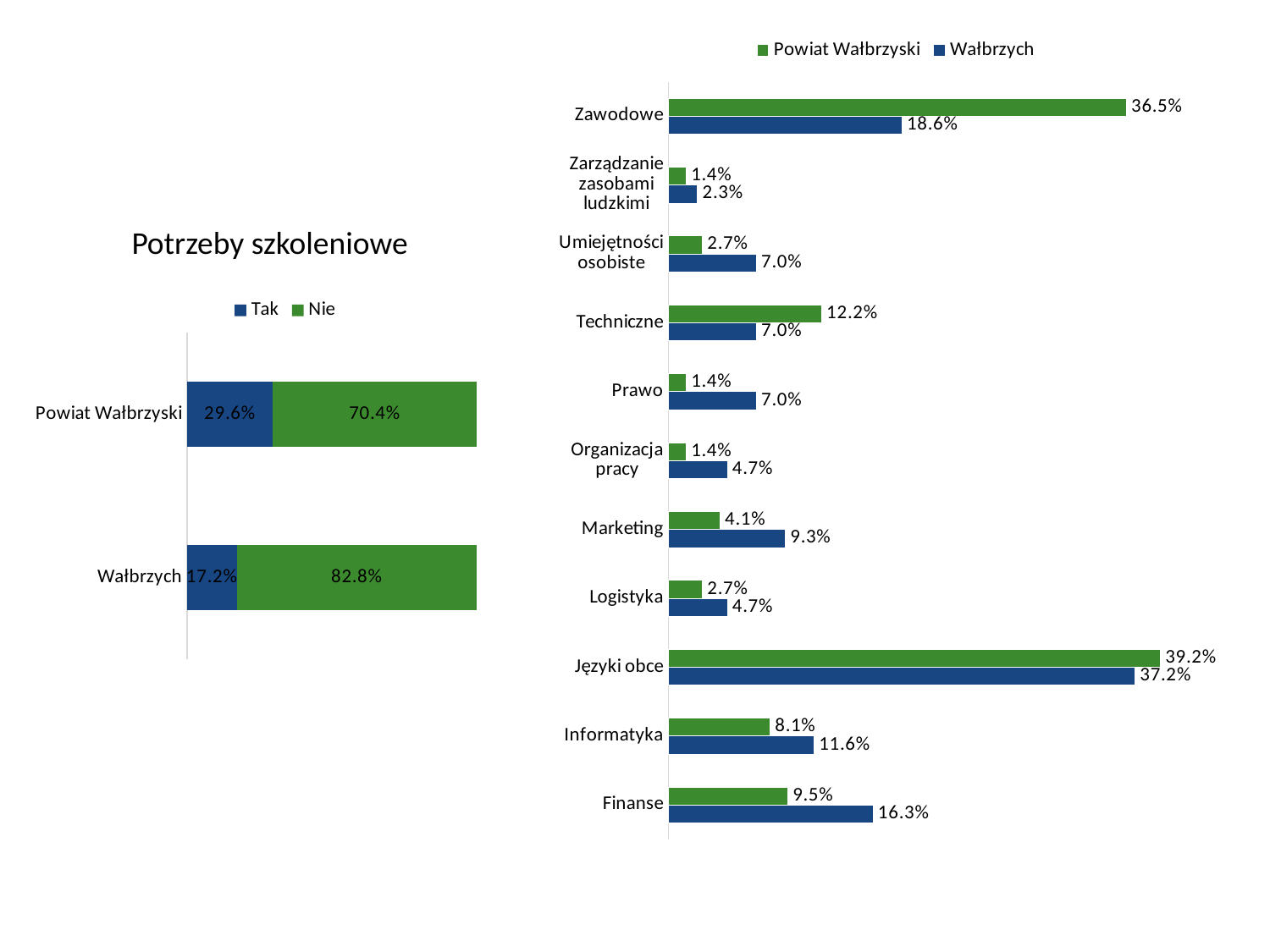
In the chart on the right, which category has the lowest Wałbrzych value? Zarządzanie zasobami ludzkimi In the 'Potrzeby szkoleniowe' chart, what is the total of the stacked bar for Wałbrzych? 100.0% In the 'Potrzeby szkoleniowe' chart, what is the 'Nie' value for Wałbrzych? 82.8% In the chart on the right, what is the difference between the Powiat Wałbrzyski and Wałbrzych values for Zawodowe? 17.9% In the chart on the right, what is the Wałbrzych value for Zawodowe? 18.6% In the chart on the right, how many categories are shown? 11 In the chart on the right, which category has the highest Powiat Wałbrzyski value? Języki obce In the 'Potrzeby szkoleniowe' chart, how many series does the legend list? 2 In the 'Potrzeby szkoleniowe' chart, what is the 'Tak' value for Powiat Wałbrzyski? 29.6% In the chart on the right, which is larger for Finanse: the Powiat Wałbrzyski value or the Wałbrzych value? Wałbrzych What kind of chart is the chart on the right? Bar chart In the chart on the right, what is the Powiat Wałbrzyski value for Języki obce? 39.2%